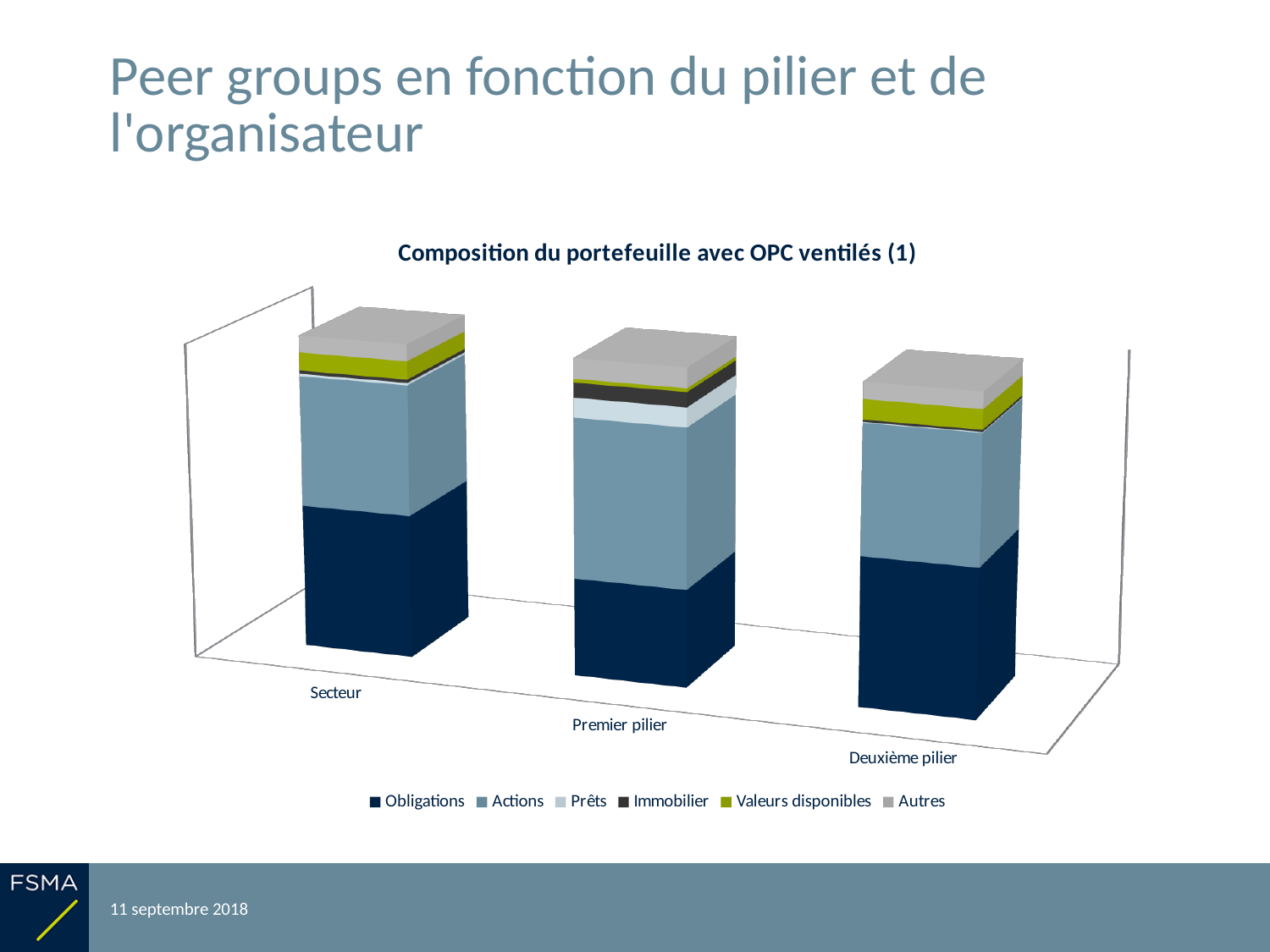
Which category has the largest Prêts segment? Premier pilier How many series does the chart legend list? 6 Is the Obligations segment larger for Premier pilier or for Deuxième pilier? Deuxième pilier Which category has the smallest Obligations segment? Premier pilier Which category has the largest Immobilier segment? Premier pilier What is the title of the chart? Composition du portefeuille avec OPC ventilés (1) Is the Actions segment larger for Secteur or for Premier pilier? Premier pilier What kind of chart is shown on the slide? Stacked bar chart How many categories are shown along the x axis of the chart? 3 Is the Prêts segment larger for Secteur or for Premier pilier? Premier pilier Which series is listed first in the chart legend? Obligations